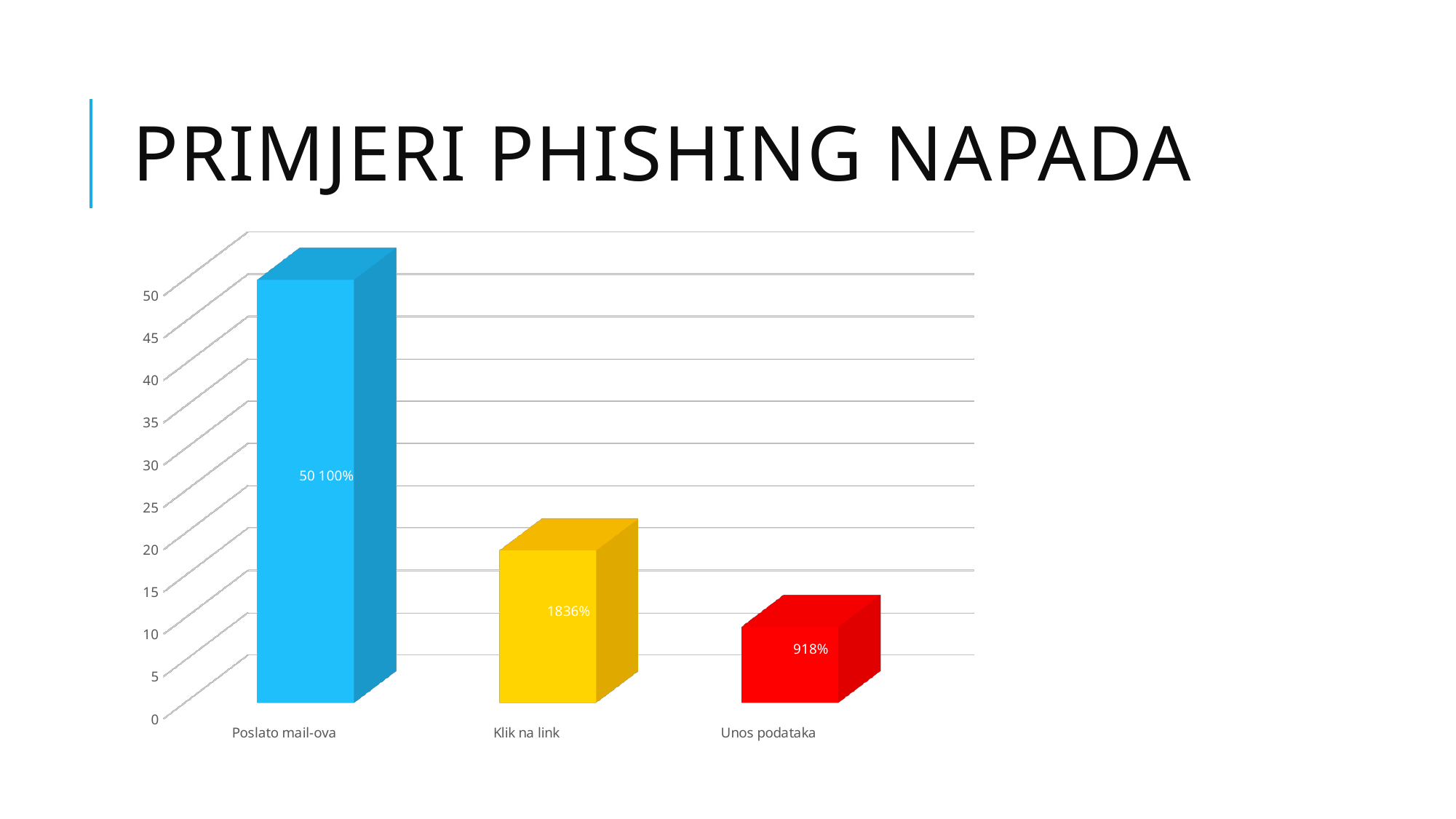
Is the bar for Unos podataka greater or less than 15 on the vertical axis? less What data label is shown on the bar for Klik na link? 1836% How many categories are shown on the chart? 3 Which category has the tallest bar? Poslato mail-ova Do the bar heights rise or fall from left to right across the categories? Fall Which category has the shortest bar? Unos podataka Is the bar for Klik na link greater or less than 25 on the vertical axis? less What data label is shown on the bar for Poslato mail-ova? 50 100% Which bar is taller, Klik na link or Unos podataka? Klik na link What kind of chart is shown on the slide? Bar chart What data label is shown on the bar for Unos podataka? 918% Is the bar for Poslato mail-ova greater or less than 40 on the vertical axis? greater